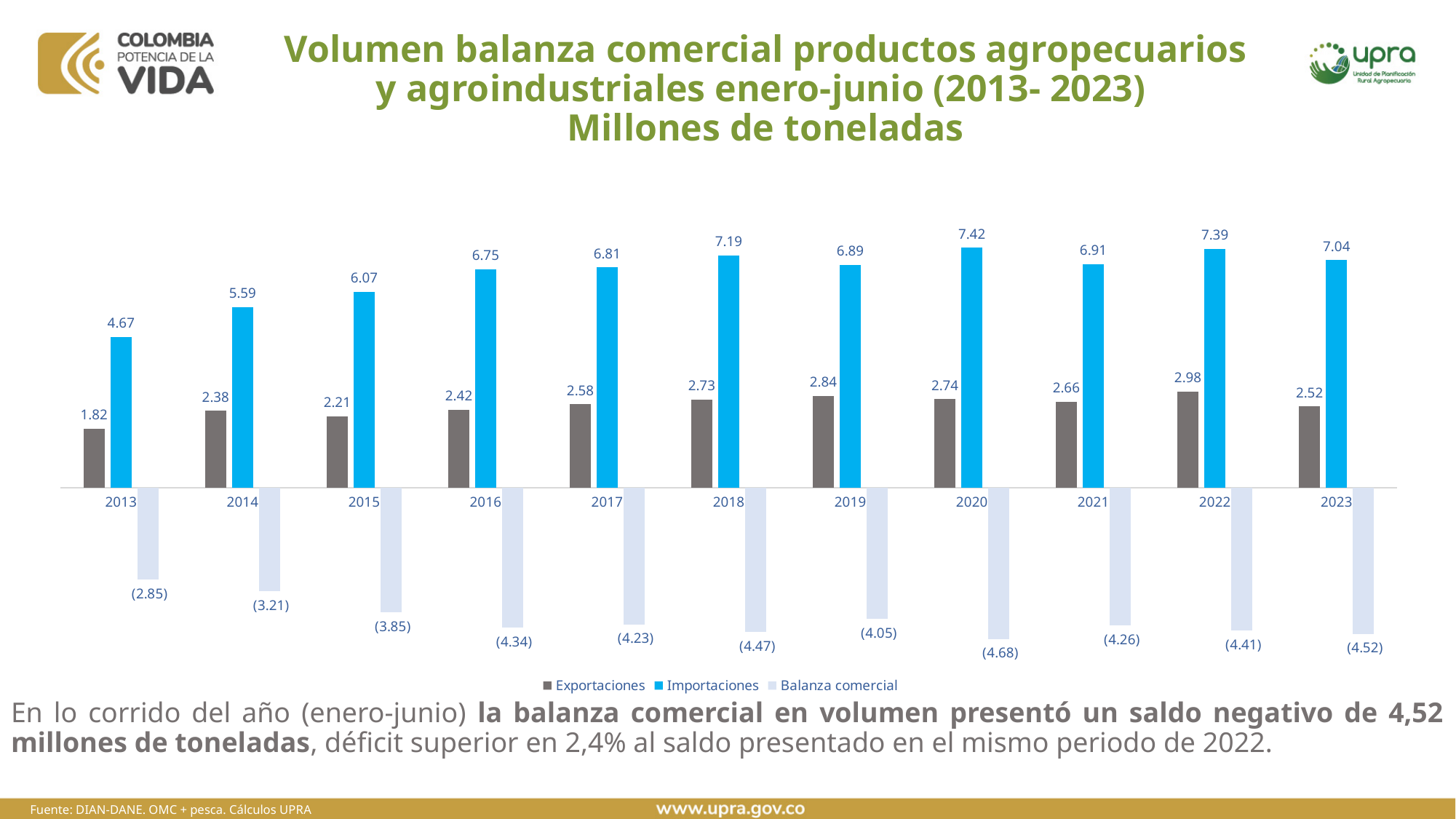
What is the difference between Importaciones and Exportaciones in 2023? 4.52 How many series does the legend list? 3 In which year is the Exportaciones value lowest? 2013 What kind of chart is shown on the slide? Bar chart What is the value of Exportaciones for 2013? 1.82 Which is larger, Importaciones in 2018 or Importaciones in 2019? Importaciones in 2018 How many years are shown on the x axis? 11 Do the Importaciones values rise or fall from 2013 to 2016? Rise What is the value of Importaciones for 2020? 7.42 In which year is the Exportaciones value highest? 2022 In which year is the Importaciones value highest? 2020 What is the value of Balanza comercial for 2023? (4.52)